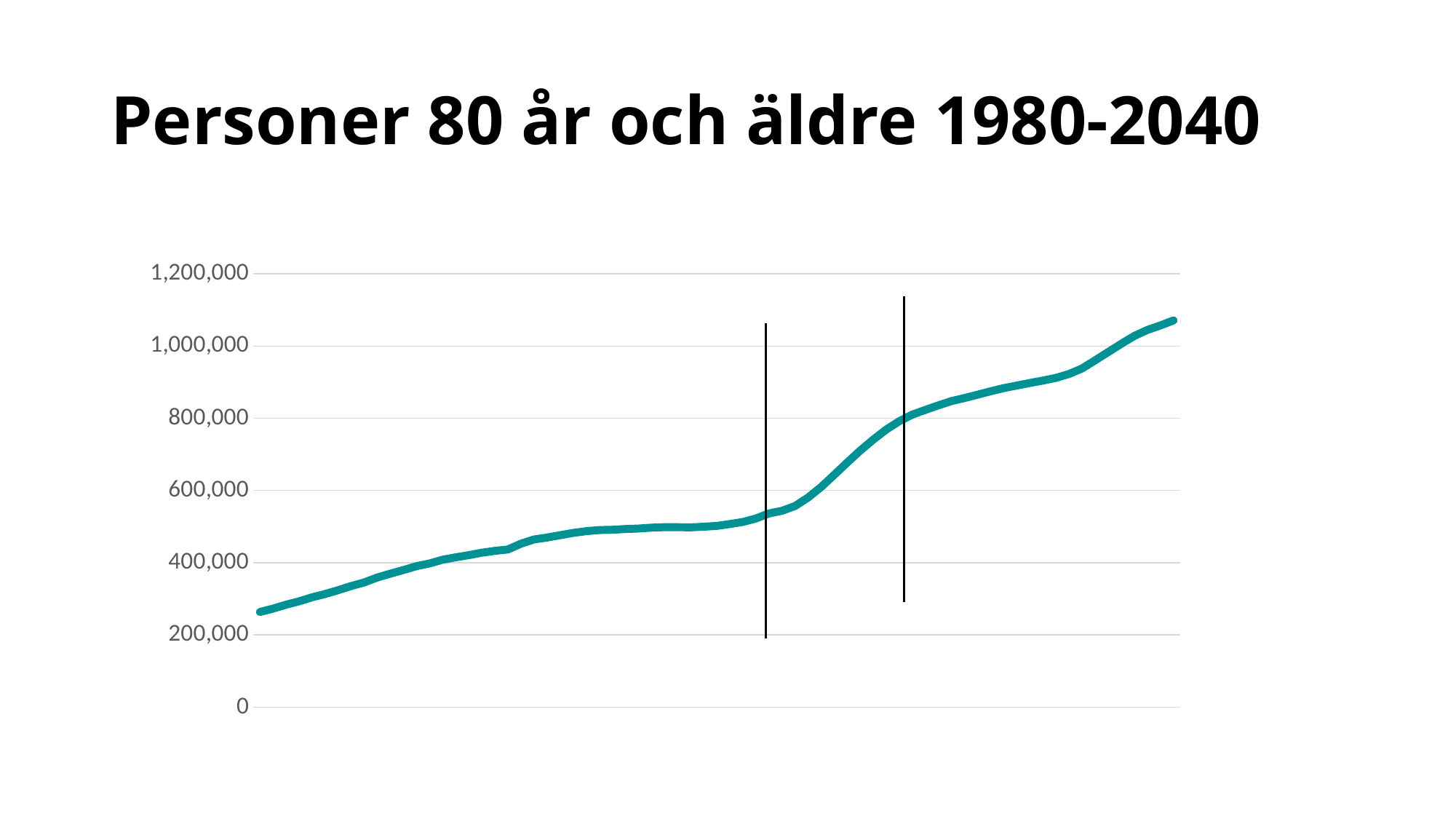
What is the highest value labelled on the vertical axis? 1,200,000 Which end of the line is higher, the left end or the right end? right end Is the value where the line crosses the first (left) vertical black line greater or less than 600,000? less Is the value at the right end of the line greater or less than 1,000,000? greater Is the value at the right end of the line greater or less than 1,200,000? less What kind of chart is shown on the slide? line chart Does the line generally rise or fall from left to right? rise What is the title of the chart on the slide? Personer 80 år och äldre 1980-2040